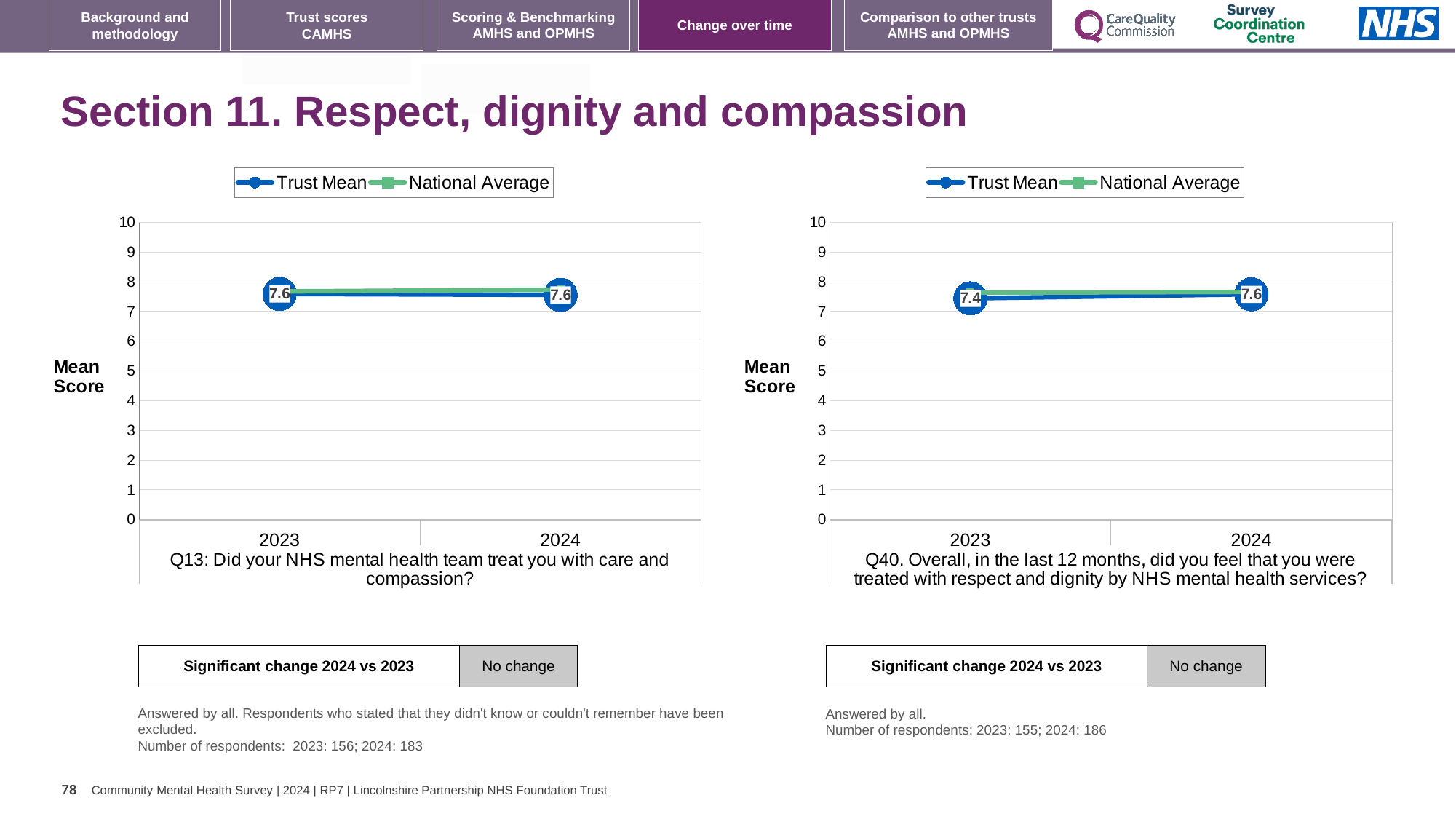
In the Q13 chart on the left, what is the Trust Mean for 2023? 7.6 What are the two series named in the legend of the Q40 chart on the right? Trust Mean and National Average In the Q40 chart on the right, what is the Trust Mean for 2023? 7.4 In the Q40 chart on the right, does the Trust Mean rise or fall from 2023 to 2024? rise How many series does the legend of the Q13 chart on the left list? 2 In the Q13 chart on the left, is the Trust Mean for 2024 greater or less than 5? greater What kind of chart is the Q13 chart on the left? line chart In the Q40 chart on the right, which year has the higher Trust Mean, 2023 or 2024? 2024 In the Q40 chart on the right, what is the Trust Mean for 2024? 7.6 In the Q40 chart on the right, what is the difference between the Trust Mean for 2024 and 2023? 0.2 How many years are plotted on the x axis of the Q40 chart on the right? 2 In the Q13 chart on the left, what is the Trust Mean for 2024? 7.6